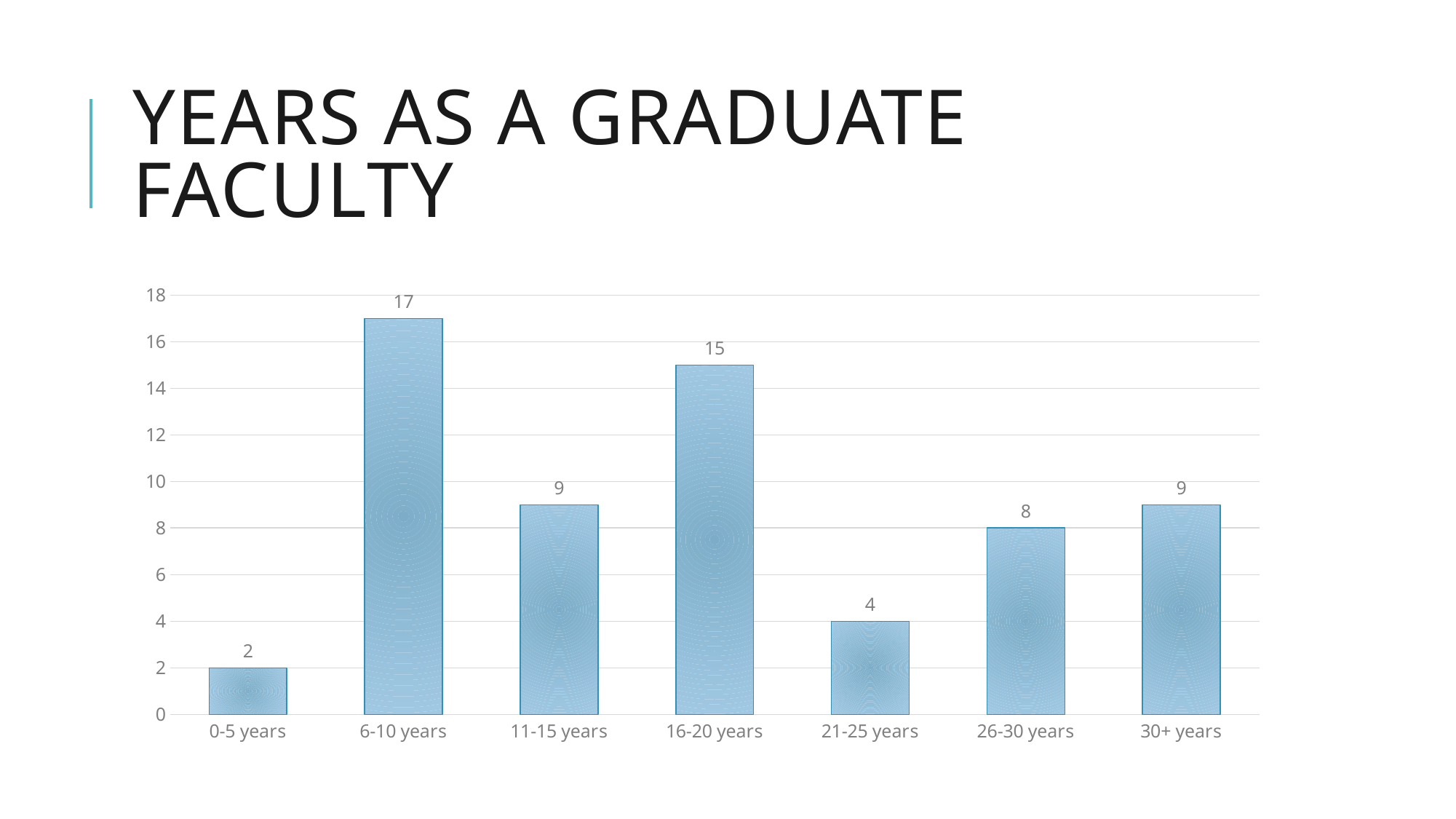
How many categories are shown on the x axis? 7 Which category has the highest value? 6-10 years What is the value for 6-10 years? 17 What is the title of the slide? Years as a Graduate Faculty What is the value for 21-25 years? 4 What is the difference between the values for 6-10 years and 16-20 years? 2 What is the value for 26-30 years? 8 Which category has the lowest value? 0-5 years What kind of chart is shown on the slide? Bar chart Is the value for 16-20 years greater or less than 10? greater Which is larger, the value for 11-15 years or the value for 26-30 years? 11-15 years What is the value for 30+ years? 9